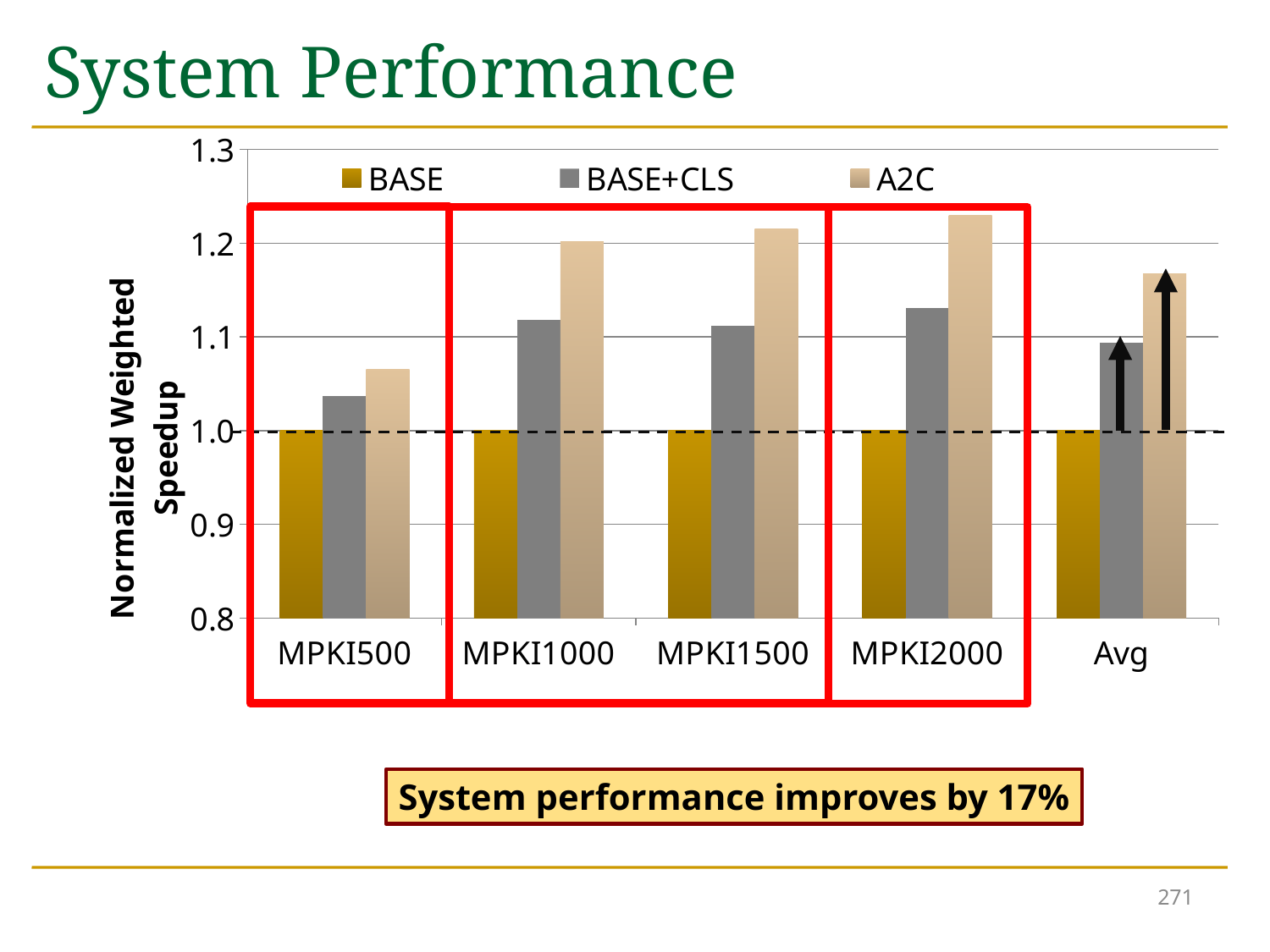
Is the BASE+CLS value for MPKI500 greater or less than 1.1? less Is the A2C value for MPKI2000 greater or less than 1.2? greater How many categories are shown on the x axis? 5 For MPKI1500, which is larger, BASE+CLS or A2C? A2C What is the value of BASE for MPKI500? 1.0 Which category has the lowest A2C value? MPKI500 Which category has the lowest BASE+CLS value? MPKI500 Is the A2C value for MPKI1000 greater or less than 1.1? greater What is the y-axis title of the chart? Normalized Weighted Speedup Do the A2C values rise or fall from MPKI500 to MPKI2000? rise What kind of chart is shown on the slide? bar chart How many series does the legend list? 3